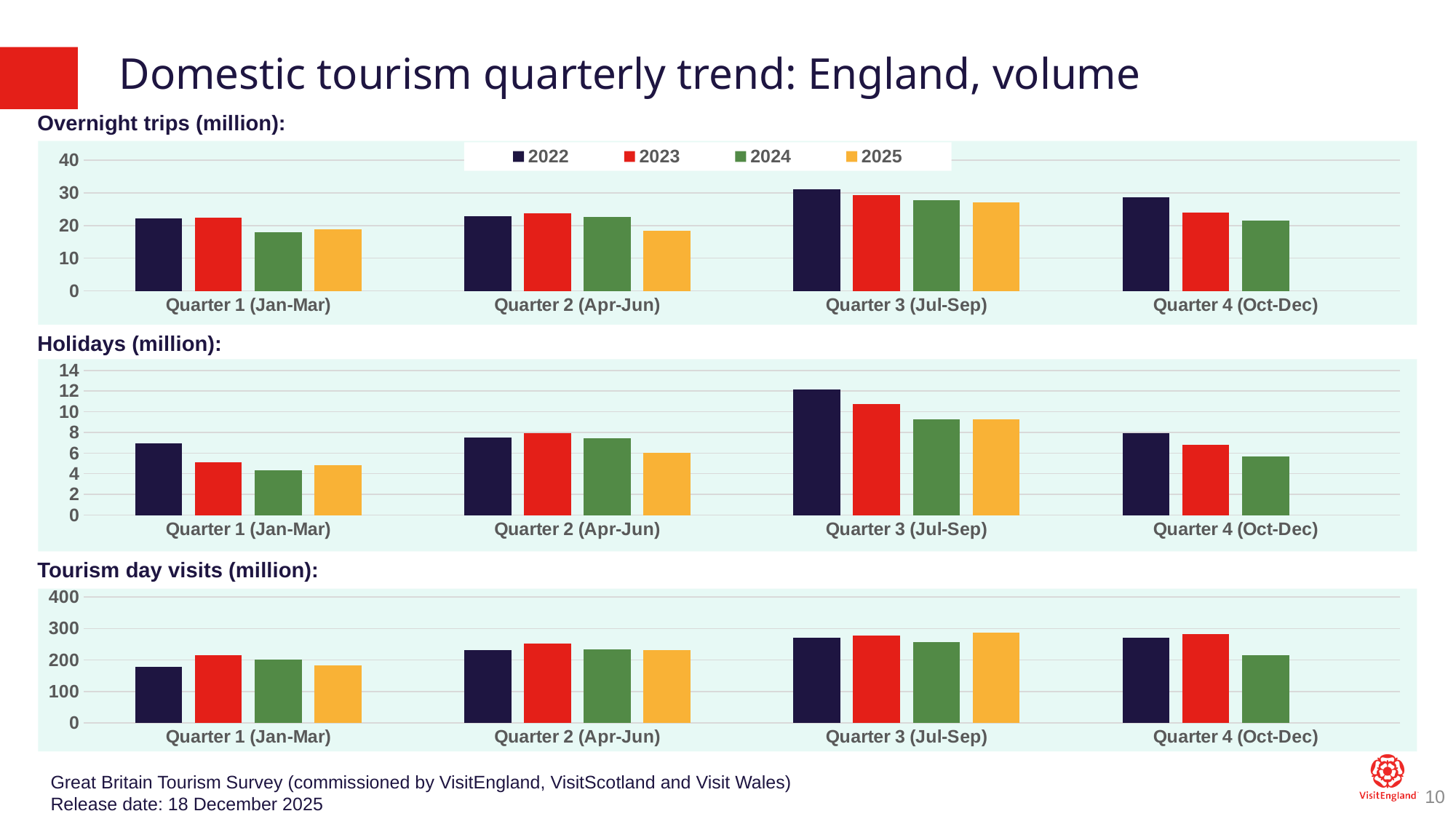
In the Overnight trips (million) chart, which is larger: 2022 in Quarter 3 (Jul-Sep) or 2024 in Quarter 1 (Jan-Mar)? 2022 in Quarter 3 (Jul-Sep) In the Holidays (million) chart, is the value for 2022 in Quarter 3 (Jul-Sep) greater or less than 10? greater In the Holidays (million) chart, which quarter and year has the highest bar? Quarter 3 (Jul-Sep), 2022 In the Overnight trips (million) chart, how many series does the legend list? 4 How many quarter categories are shown on the x axis of the Tourism day visits (million) chart? 4 In the Overnight trips (million) chart, which quarter and year has the highest bar? Quarter 3 (Jul-Sep), 2022 In the Overnight trips (million) chart, is the value for 2022 in Quarter 4 (Oct-Dec) greater or less than 20? greater In the Tourism day visits (million) chart, which is larger: 2023 in Quarter 2 (Apr-Jun) or 2022 in Quarter 1 (Jan-Mar)? 2023 in Quarter 2 (Apr-Jun) In the Tourism day visits (million) chart, is the value for 2022 in Quarter 1 (Jan-Mar) greater or less than 200? less What kind of chart is the Holidays (million) chart? Bar chart